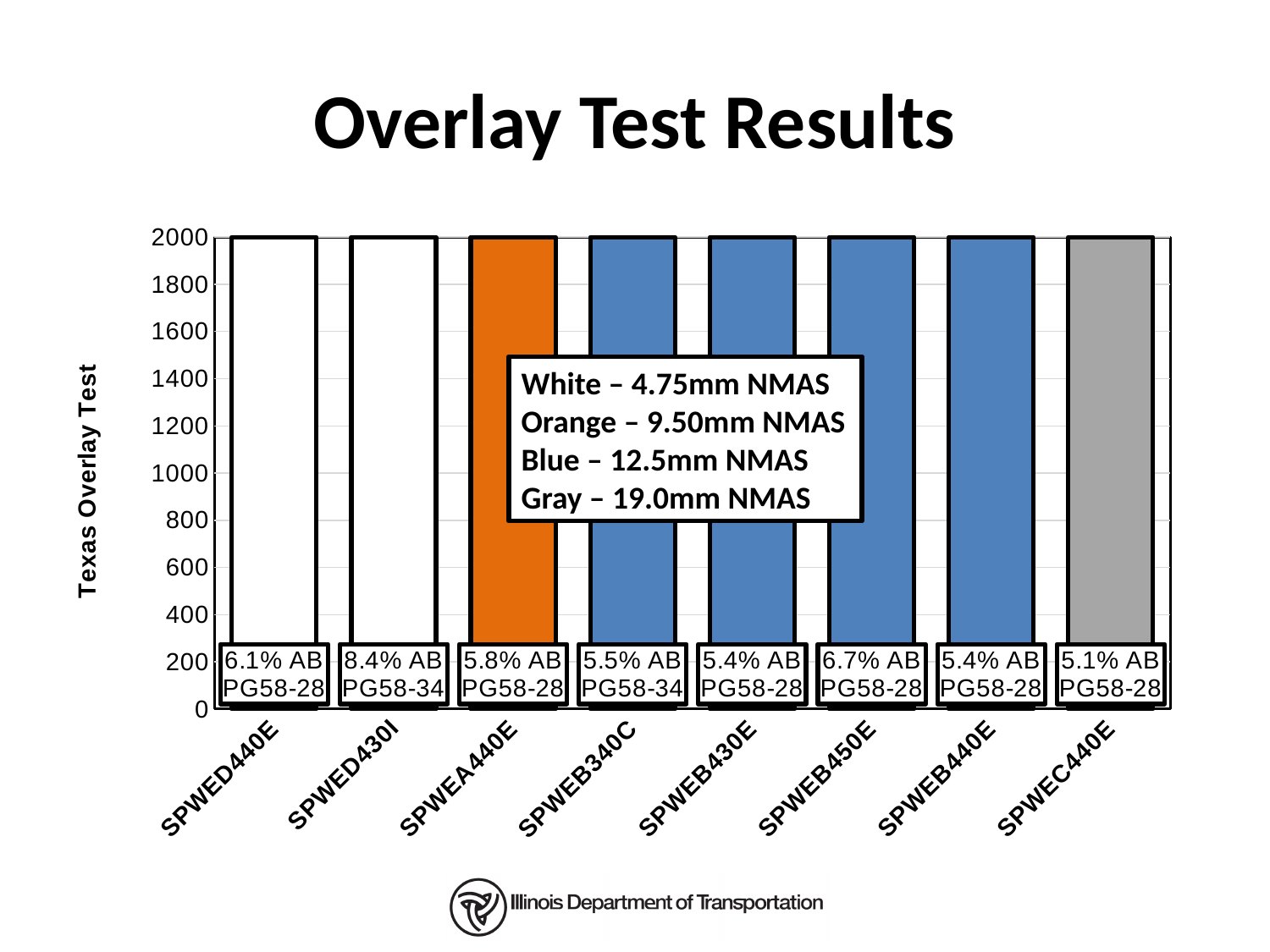
What is the title of the chart? Overlay Test Results Is the value for SPWEB450E greater or less than 1000? greater What asphalt binder content is printed on the bar for SPWED430I? 8.4% AB What is the label of the y axis? Texas Overlay Test How many mix categories are plotted on the x axis? 8 What PG grade is printed on the bar for SPWEB340C? PG58-34 What is the Texas Overlay Test value for SPWED440E? 2000 Which mix has the highest asphalt binder content printed on its bar? SPWED430I What is the Texas Overlay Test value for SPWEC440E? 2000 What is the difference between the values for SPWEA440E and SPWEB340C? 0 What kind of chart is shown on the slide? bar chart Which mix has the lowest asphalt binder content printed on its bar? SPWEC440E